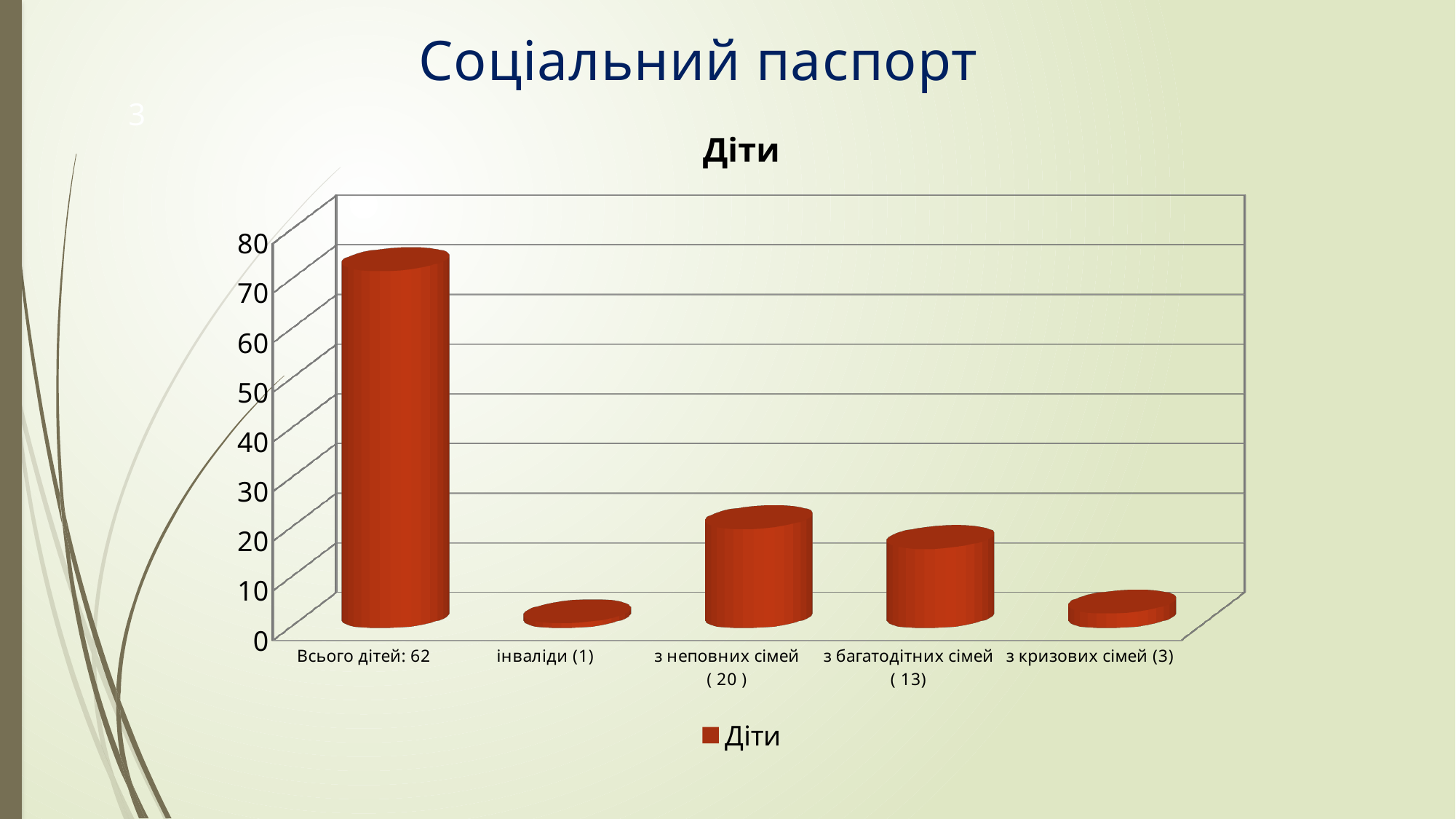
What is the difference between the values for 'з неповних сімей' (20) and 'з багатодітних сімей' (13)? 7 How many series does the legend list? 1 What is the title of the chart? Діти Which category has the lowest bar? інваліди (1) What value is given for the category 'з неповних сімей'? 20 How many categories are shown on the x axis of the chart? 5 Is the value for 'Всього дітей' greater or less than 50? greater What kind of chart is shown on the slide? bar chart Which is larger, the value for 'з неповних сімей' or for 'з багатодітних сімей'? з неповних сімей What value is given for the category 'з кризових сімей'? 3 Which category has the highest bar? Всього дітей: 62